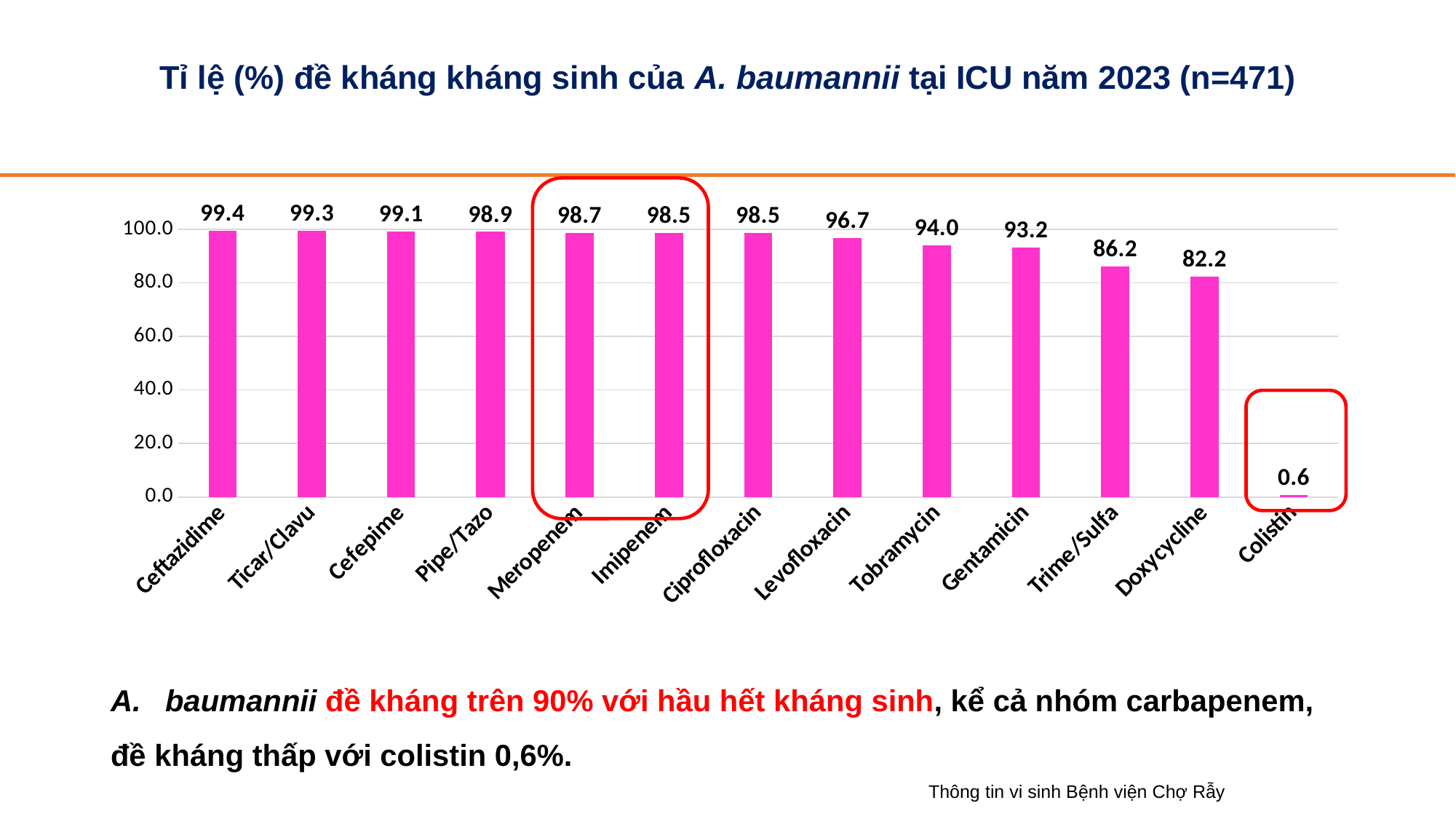
Do the values generally rise or fall from left to right along the x axis? fall Which antibiotic has the lowest resistance rate? Colistin What is the resistance rate for Meropenem? 98.7 What is the difference between the resistance rates for Trime/Sulfa and Doxycycline? 4.0 What colour are the bars in the chart? pink Is the value for Levofloxacin greater or less than 80.0? greater What is the resistance rate for Colistin? 0.6 Which has a higher resistance rate, Tobramycin or Gentamicin? Tobramycin What kind of chart is shown on the slide? bar chart What is the resistance rate for Doxycycline? 82.2 How many antibiotics are shown on the x axis? 13 Which antibiotic has the highest resistance rate? Ceftazidime